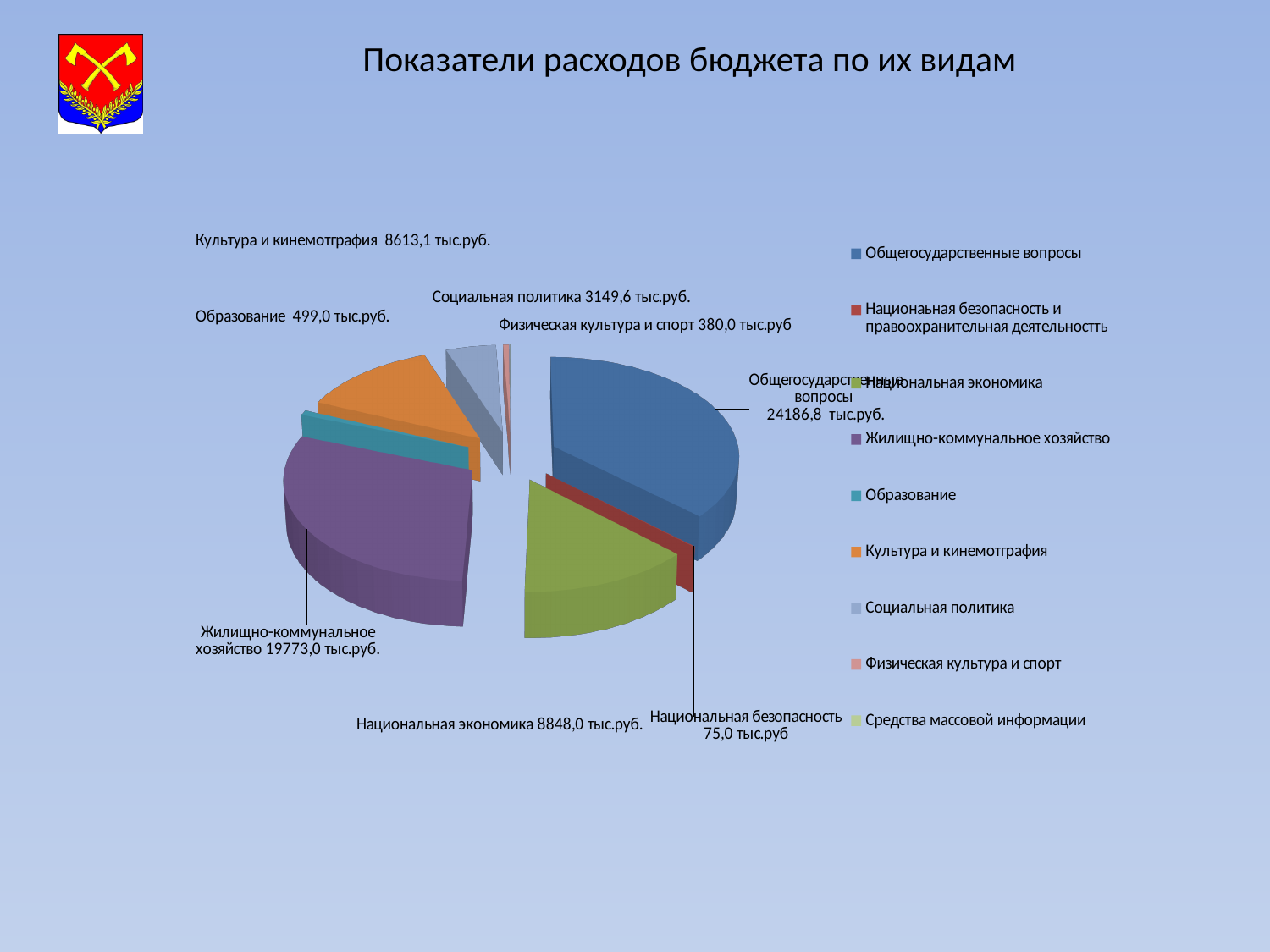
How many entries does the chart legend list? 9 Which category has the largest value in the chart? Общегосударственные вопросы What is the value shown for Жилищно-коммунальное хозяйство? 19773,0 тыс.руб. What kind of chart is shown on the slide? Pie chart What is the value shown for Общегосударственные вопросы? 24186,8 тыс.руб. What is the difference between the values for Общегосударственные вопросы and Жилищно-коммунальное хозяйство? 4413,8 тыс.руб. What is the value shown for Национальная экономика? 8848,0 тыс.руб. Which is larger, the value for Образование or the value for Физическая культура и спорт? Образование What is the title of the chart on the slide? Показатели расходов бюджета по их видам What is the value shown for Национальная безопасность? 75,0 тыс.руб What is the value shown for Социальная политика? 3149,6 тыс.руб. What is the value shown for Культура и кинемотграфия? 8613,1 тыс.руб.